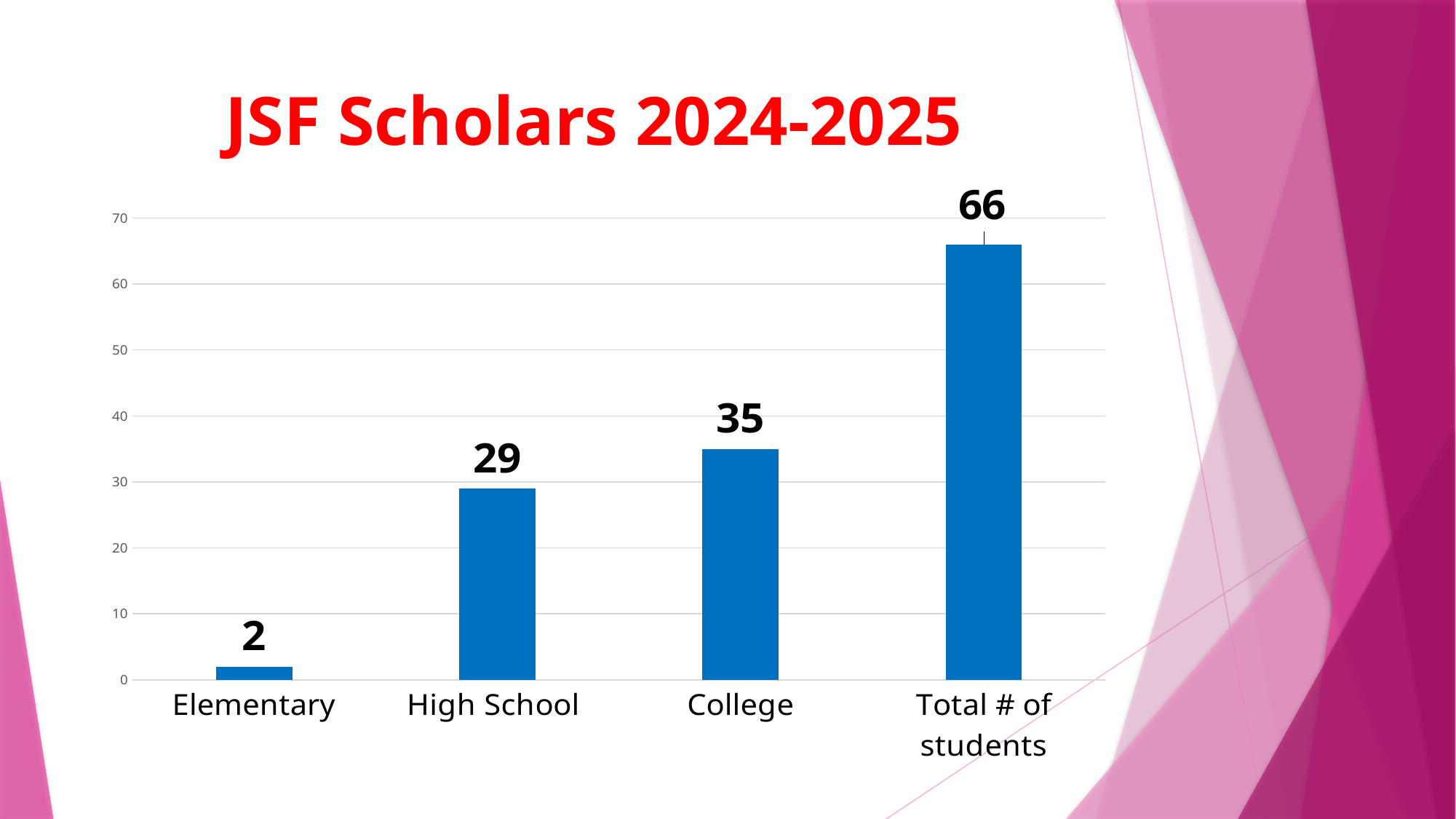
Which is larger, the value for College or the value for High School? College What is the value for High School? 29 What is the value for Total # of students? 66 Is the value for Total # of students greater or less than 60? greater Which category has the lowest value? Elementary What is the value for Elementary? 2 What is the difference between the values for College and High School? 6 How many categories are shown on the x axis? 4 What is the value for College? 35 What is the title of the slide? JSF Scholars 2024-2025 What kind of chart is shown on the slide? bar chart Which category has the highest value? Total # of students